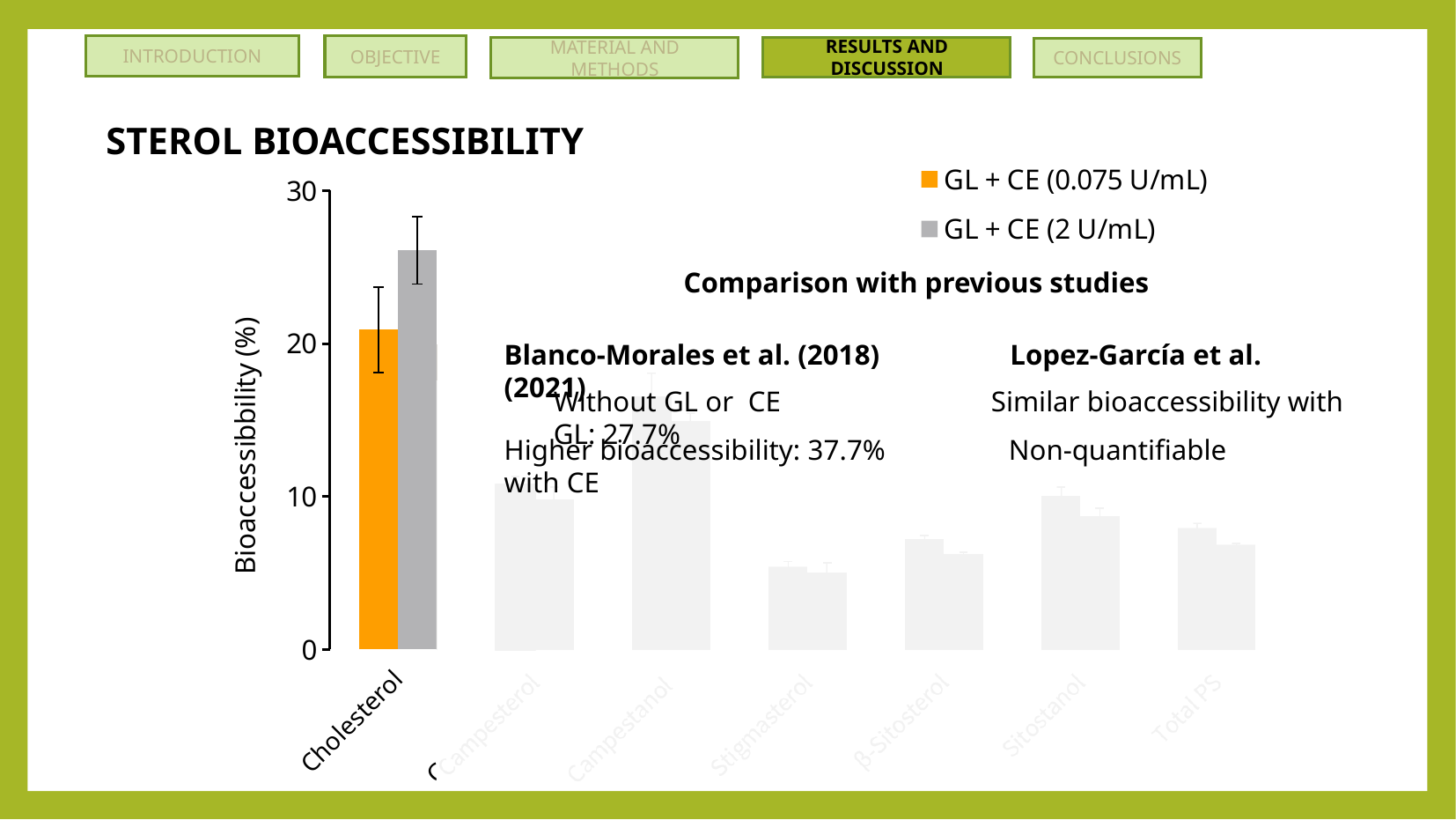
Which series is shown in orange in the chart legend? GL + CE (0.075 U/mL) How many categories are shown on the x axis of the chart? 7 Is the value for Stigmasterol in the GL + CE (0.075 U/mL) series greater or less than 10? less Is the value for Cholesterol in the GL + CE (2 U/mL) series greater or less than 30? less For Cholesterol, which series has the larger value: GL + CE (0.075 U/mL) or GL + CE (2 U/mL)? GL + CE (2 U/mL) Is the value for Campestanol in the GL + CE (2 U/mL) series greater or less than 10? greater Which category has the highest bioaccessibility in the chart? Cholesterol What is the label of the y axis of the chart? Bioaccessibbility (%) How many series does the chart legend list? 2 What kind of chart is shown on the slide? bar chart